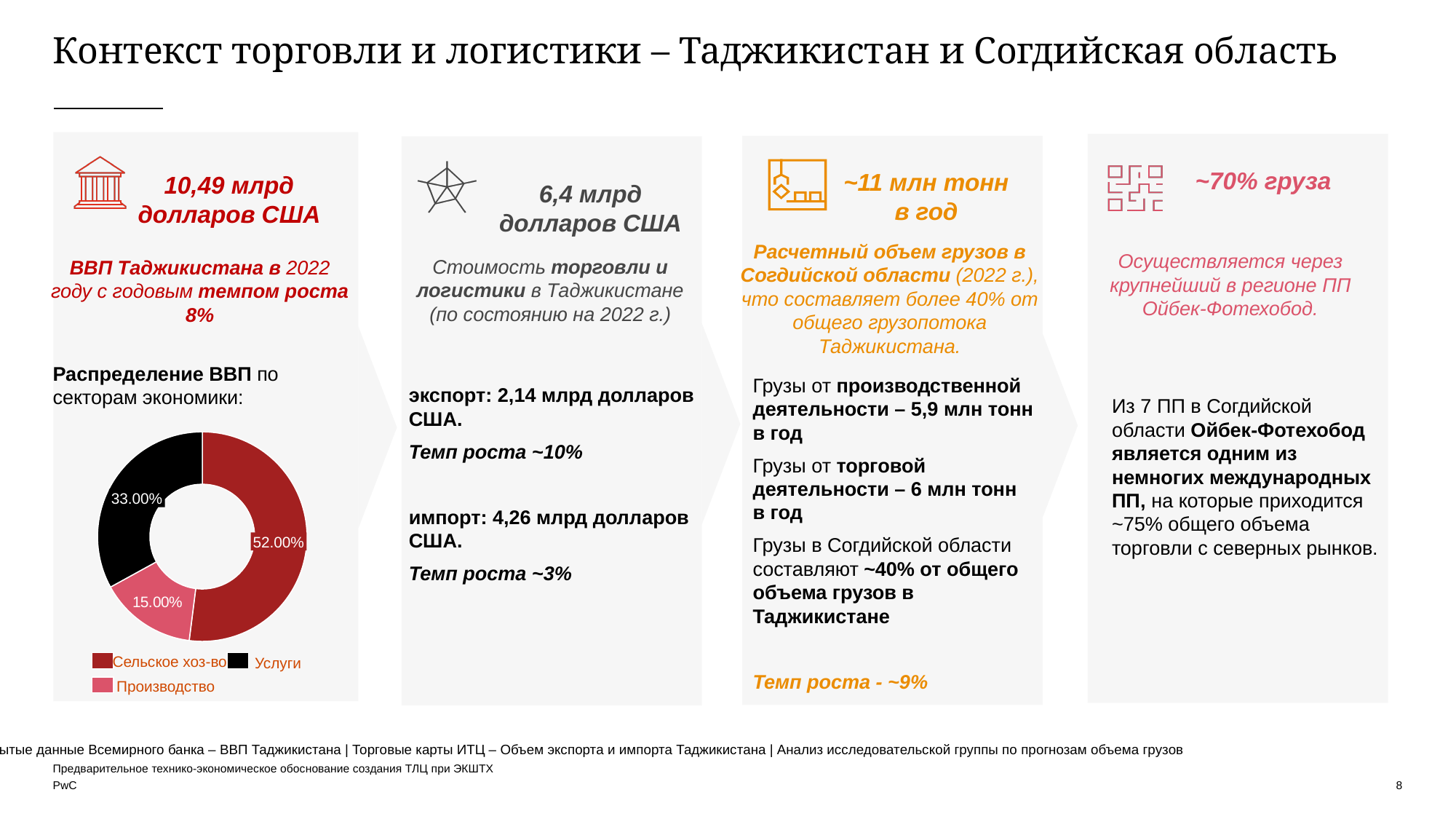
What share of GDP does Производство account for in the pie chart? 15.00% Which has a larger share in the pie chart, Услуги or Производство? Услуги What share of GDP does Сельское хоз-во account for in the pie chart? 52.00% Which sector has the largest share in the GDP distribution pie chart? Сельское хоз-во How many entries does the legend of the GDP distribution pie chart list? 3 What kind of chart is used to show the distribution of GDP by economic sector? Pie chart (donut) Which colour represents Услуги in the GDP distribution pie chart? Black Which sector has the smallest share in the GDP distribution pie chart? Производство What share of GDP does Услуги account for in the pie chart? 33.00% How many sectors are shown in the GDP distribution pie chart? 3 What is the difference in percentage points between the Услуги and Производство shares in the pie chart? 18.00% What is the difference in percentage points between the Сельское хоз-во and Услуги shares in the pie chart? 19.00%